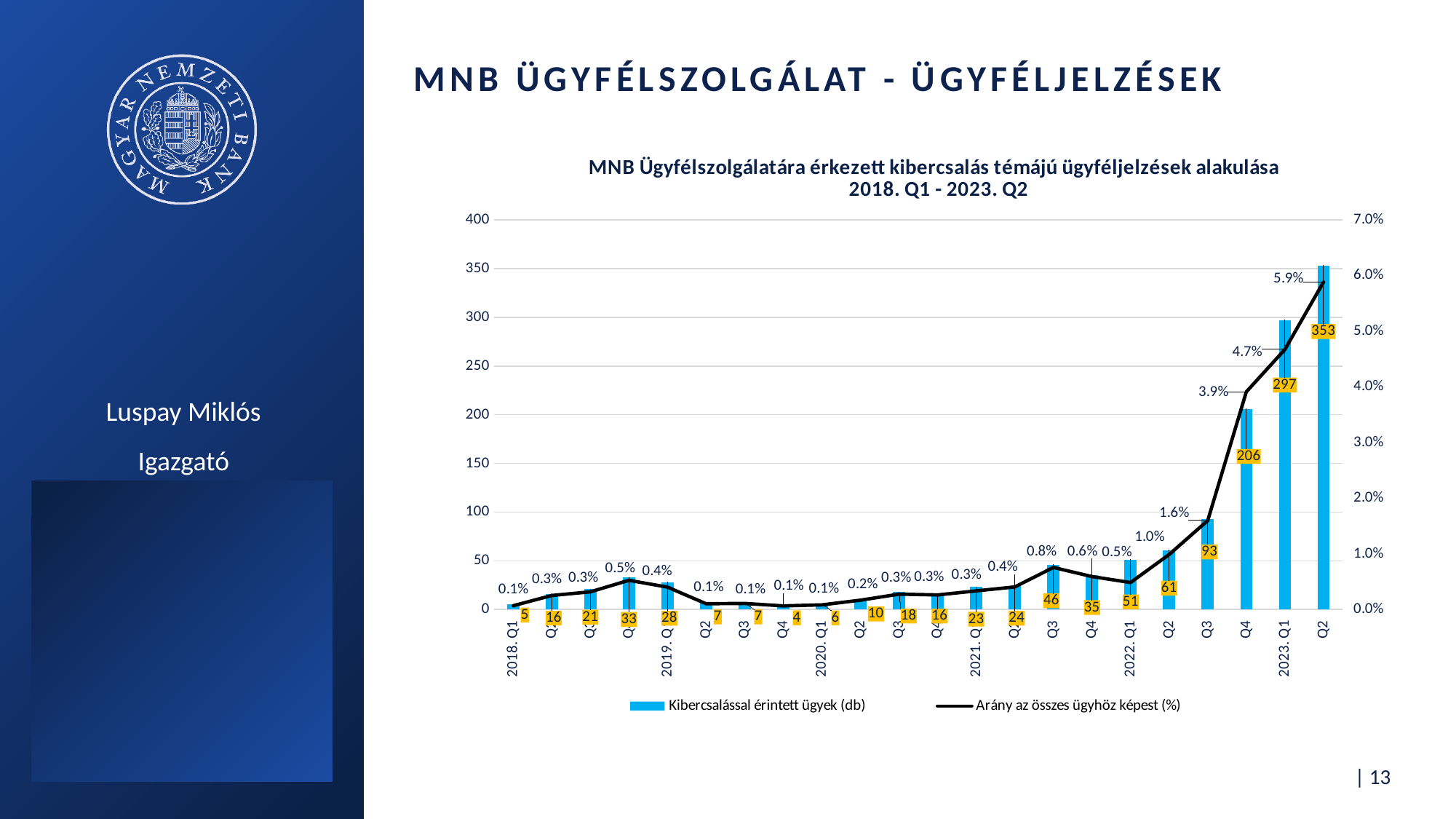
How many cyber fraud cases were recorded in 2018. Q1? 5 Which quarter had more cyber fraud cases, 2021. Q3 or 2021. Q4? 2021. Q3 How many series does the legend list? 2 What is the difference in cyber fraud cases between 2023. Q2 and 2023. Q1? 56 What is the maximum value shown on the right-hand percentage axis? 7.0% What kind of chart is shown on the slide? Combined bar and line chart Which quarter has the lowest number of cyber fraud cases? 2019. Q4 How many quarters are shown on the x axis of the chart? 22 What was the share of cyber fraud cases relative to all cases (Arány az összes ügyhöz képest) in 2022. Q4? 3.9% From 2022. Q1 to 2023. Q2, do the cyber fraud case numbers rise or fall? Rise How many cases affected by cyber fraud (Kibercsalással érintett ügyek) were recorded in 2023. Q2? 353 Which quarter has the highest number of cyber fraud cases? 2023. Q2